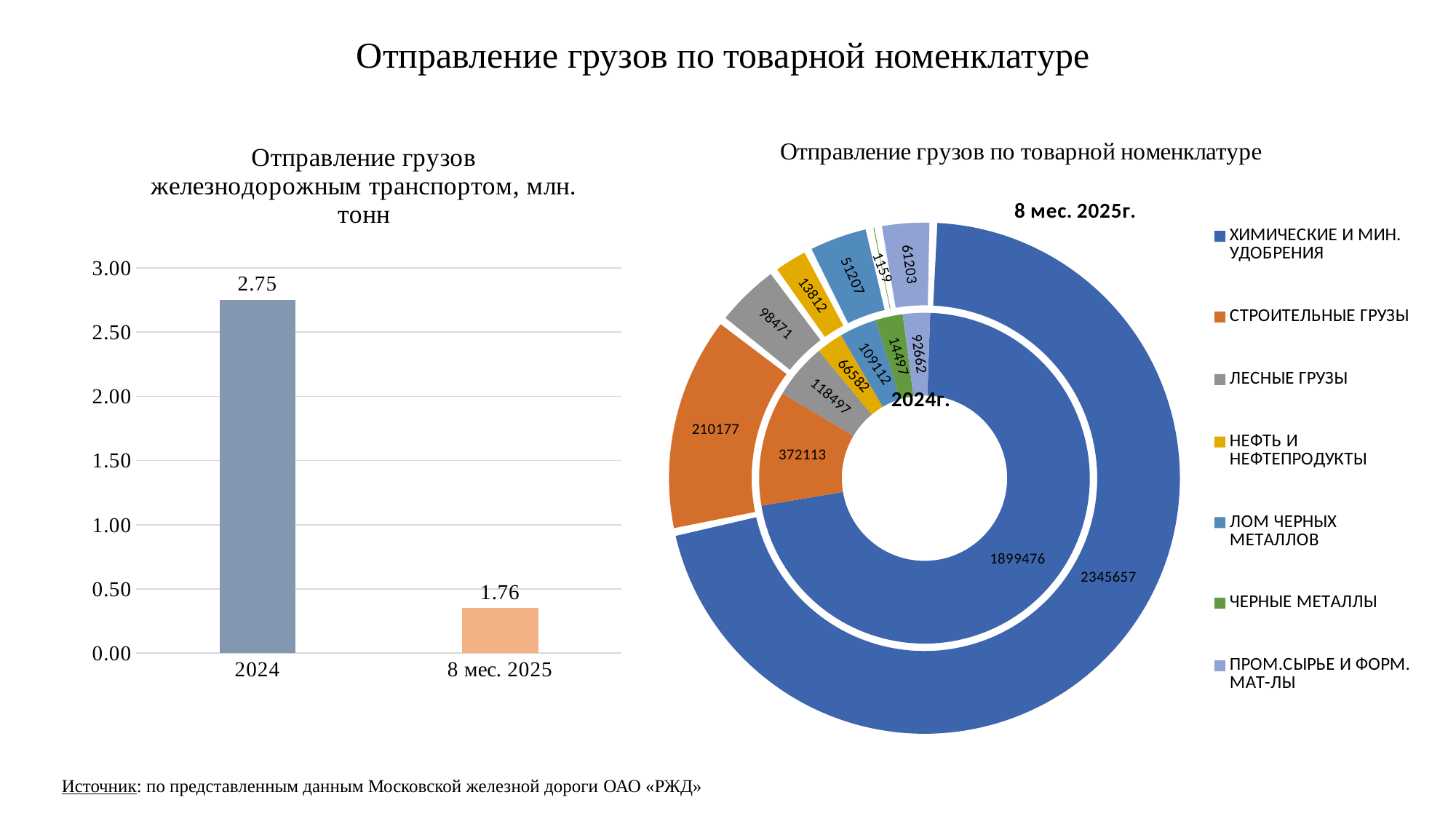
What kind of chart is the left chart titled 'Отправление грузов железнодорожным транспортом, млн. тонн'? bar chart In the right doughnut chart, what is the difference between the ЛЕСНЫЕ ГРУЗЫ value for 2024г. and for 8 мес. 2025г.? 20026 In the right doughnut chart, what is the value for ХИМИЧЕСКИЕ И МИН. УДОБРЕНИЯ in the 2024г. ring? 1899476 In the right doughnut chart, what is the value for СТРОИТЕЛЬНЫЕ ГРУЗЫ in the 8 мес. 2025г. ring? 210177 In the left bar chart, what is the difference between the 2024 value and the 8 мес. 2025 value? 0.99 How many categories does the legend of the right doughnut chart list? 7 In the left bar chart, what is the value for 2024? 2.75 In the right doughnut chart, which category has the smallest value in the 8 мес. 2025г. ring? ЧЕРНЫЕ МЕТАЛЛЫ In the right doughnut chart, which category has the largest value in the 2024г. ring? ХИМИЧЕСКИЕ И МИН. УДОБРЕНИЯ How many categories are shown in the left bar chart? 2 What kind of chart is the right chart titled 'Отправление грузов по товарной номенклатуре'? doughnut chart In the left bar chart, what is the value for 8 мес. 2025? 1.76